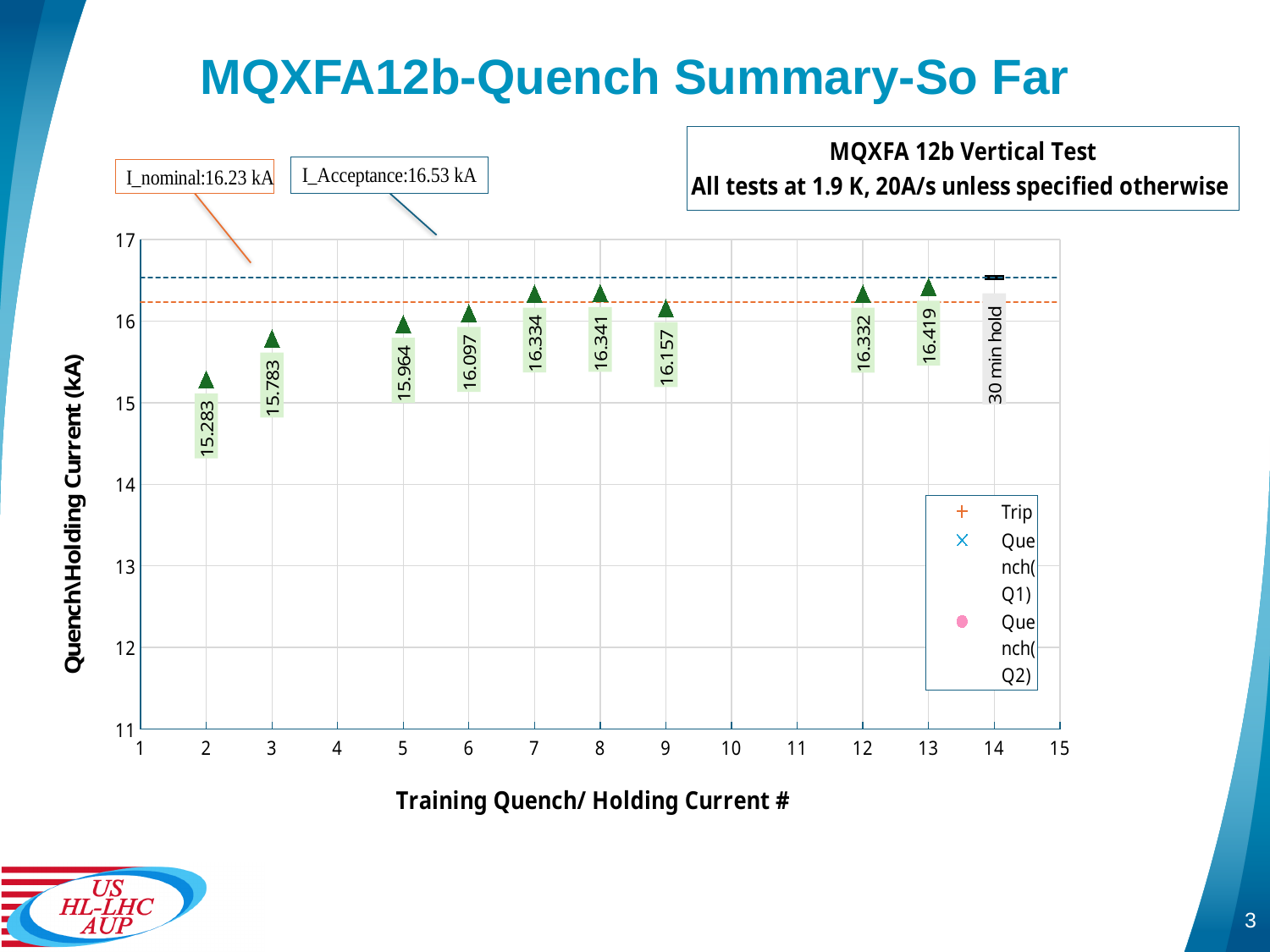
What is the quench current labeled for training quench #9? 16.157 How many quench points have numeric data labels on the chart? 9 What is the difference between the quench currents at training quench #3 and training quench #2? 0.500 What kind of chart is shown on the slide? Scatter chart What is the quench current labeled for training quench #13? 16.419 How many entries does the legend list? 3 What is the quench current labeled for training quench #2? 15.283 Is the quench current for training quench #2 greater or less than 15? greater Which training quench number has the highest labeled quench current? 13 What value is given for I_nominal on the chart? 16.23 kA Which training quench number has the lowest labeled quench current? 2 Which has a higher quench current, training quench #9 or training quench #12? Training quench #12